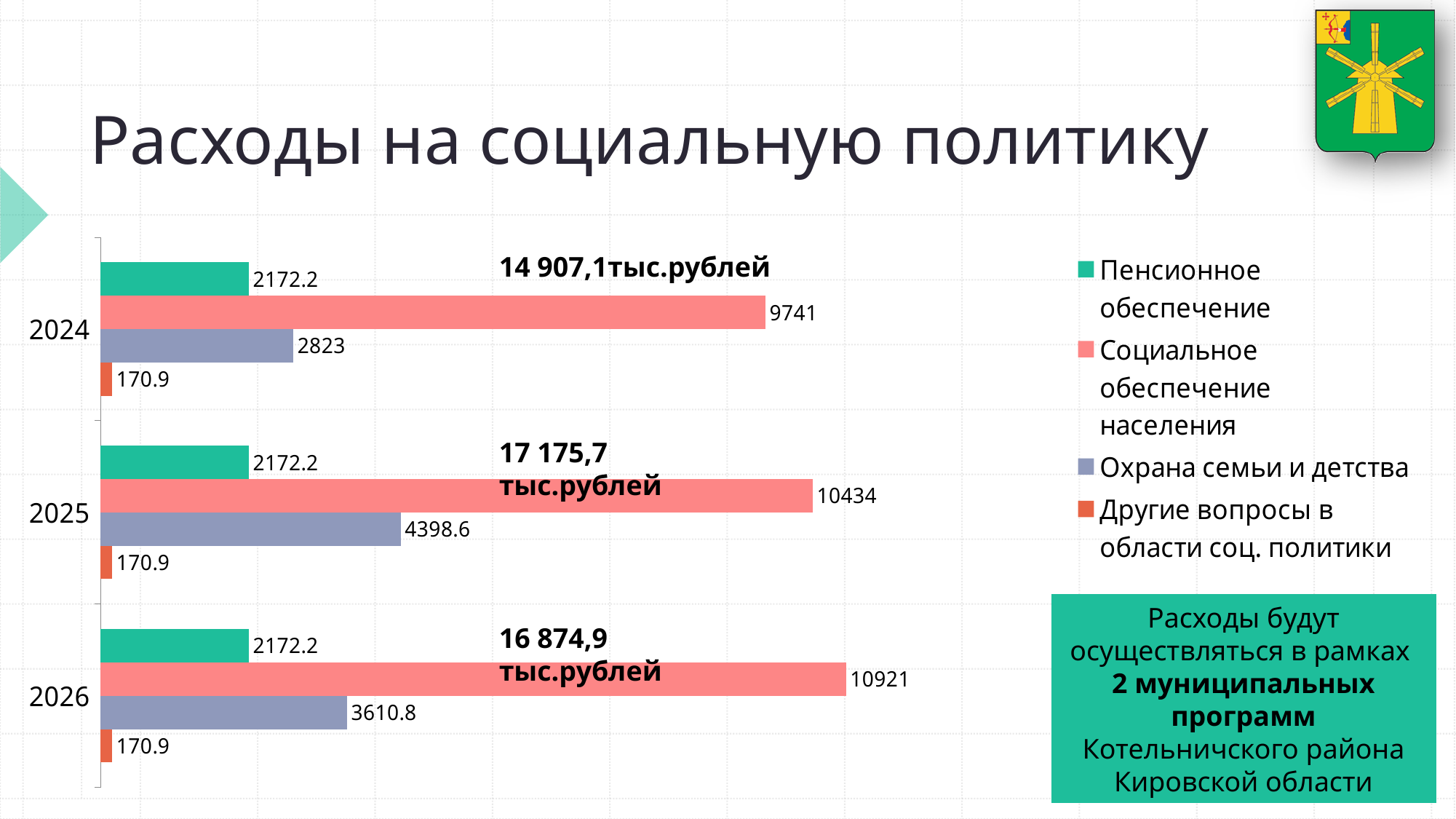
Does the value for Социальное обеспечение населения rise or fall from 2024 to 2026? Rises What is the value for Другие вопросы в области соц. политики in 2026? 170.9 What is the value for Социальное обеспечение населения in 2024? 9741 Which series has the lowest value in 2024? Другие вопросы в области соц. политики How many series does the legend list? 4 What is the value for Охрана семьи и детства in 2025? 4398.6 Which is larger: Охрана семьи и детства in 2025 or in 2026? 2025 What kind of chart is shown on the slide? Bar chart What is the difference between the Социальное обеспечение населения values for 2026 and 2024? 1180 Which series has the highest value in 2025? Социальное обеспечение населения What is the value for Пенсионное обеспечение in 2026? 2172.2 How many years (categories) are shown on the chart? 3